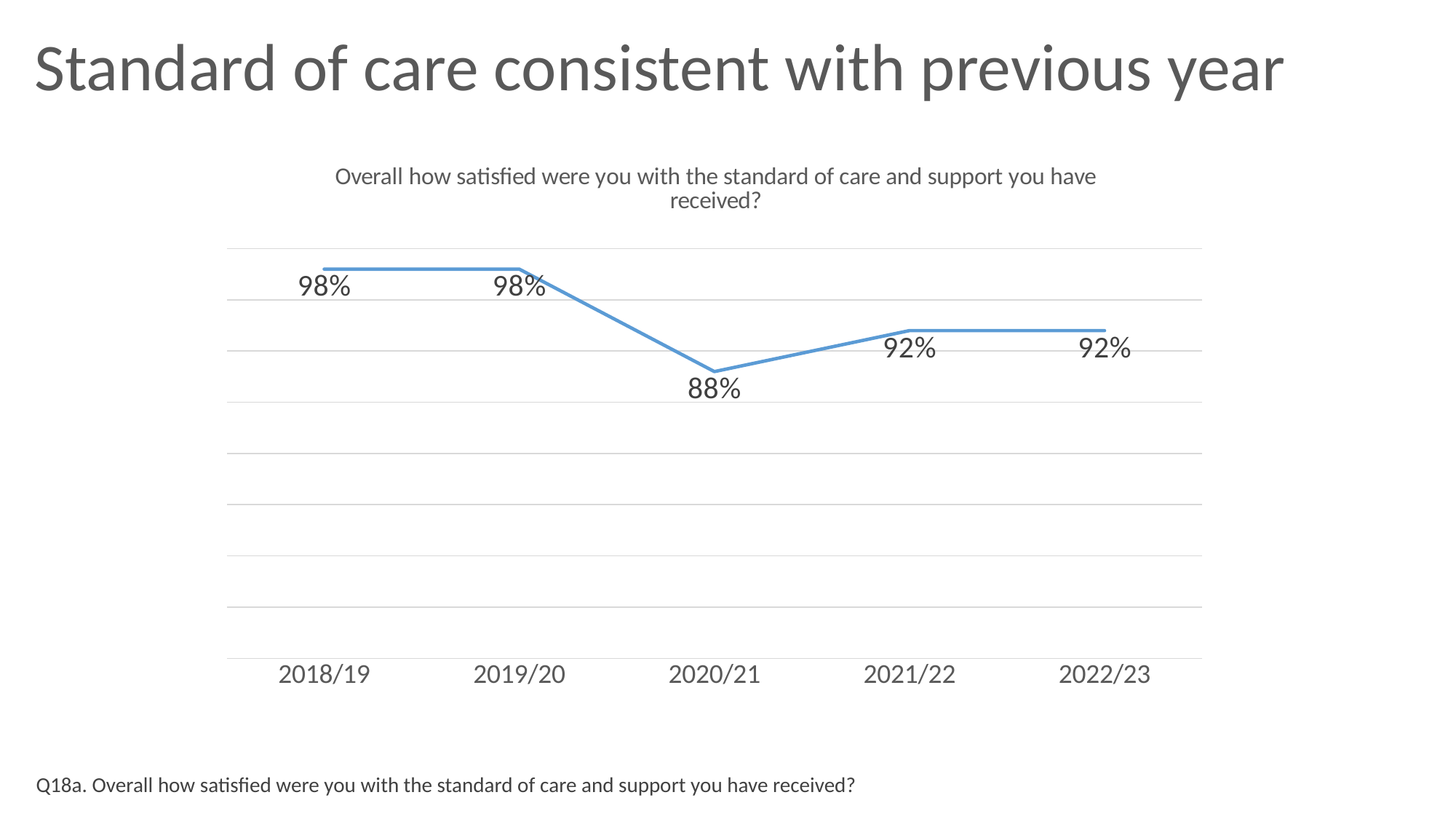
What was the satisfaction value for 2020/21? 88% What was the satisfaction value for 2022/23? 92% What is the difference between the 2021/22 value and the 2020/21 value? 4% What kind of chart is shown on the slide? Line chart Which is larger, the value for 2018/19 or the value for 2022/23? 2018/19 What was the satisfaction value for 2018/19? 98% How many years are plotted on the chart? 5 Which year has the lowest satisfaction value? 2020/21 What is the difference between the 2019/20 value and the 2020/21 value? 10% Did the satisfaction value rise, fall or stay the same from 2021/22 to 2022/23? Stayed the same Did the satisfaction value rise or fall from 2019/20 to 2020/21? Fall What is the title of the chart? Overall how satisfied were you with the standard of care and support you have received?